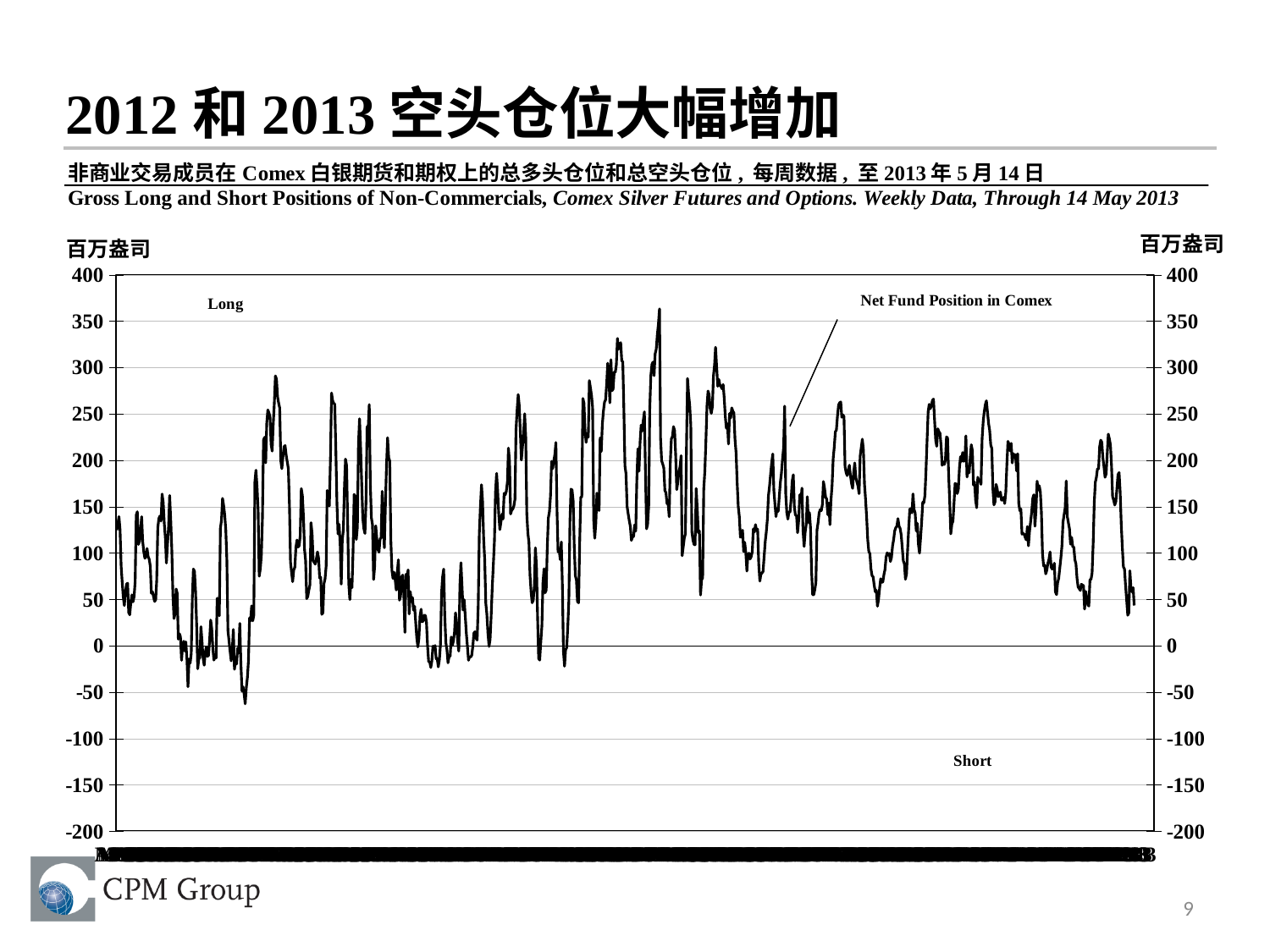
What kind of chart is shown on the slide? line chart What is the lowest value shown on the vertical axis? -200 Is the final value of the line at the right end of the chart greater or less than 100? less Is the final value of the line at the right end of the chart greater or less than 0? greater Is the peak value of the plotted line greater or less than 300? greater What label is attached to the plotted line by the arrow annotation? Net Fund Position in Comex What is the highest value shown on the left vertical axis? 400